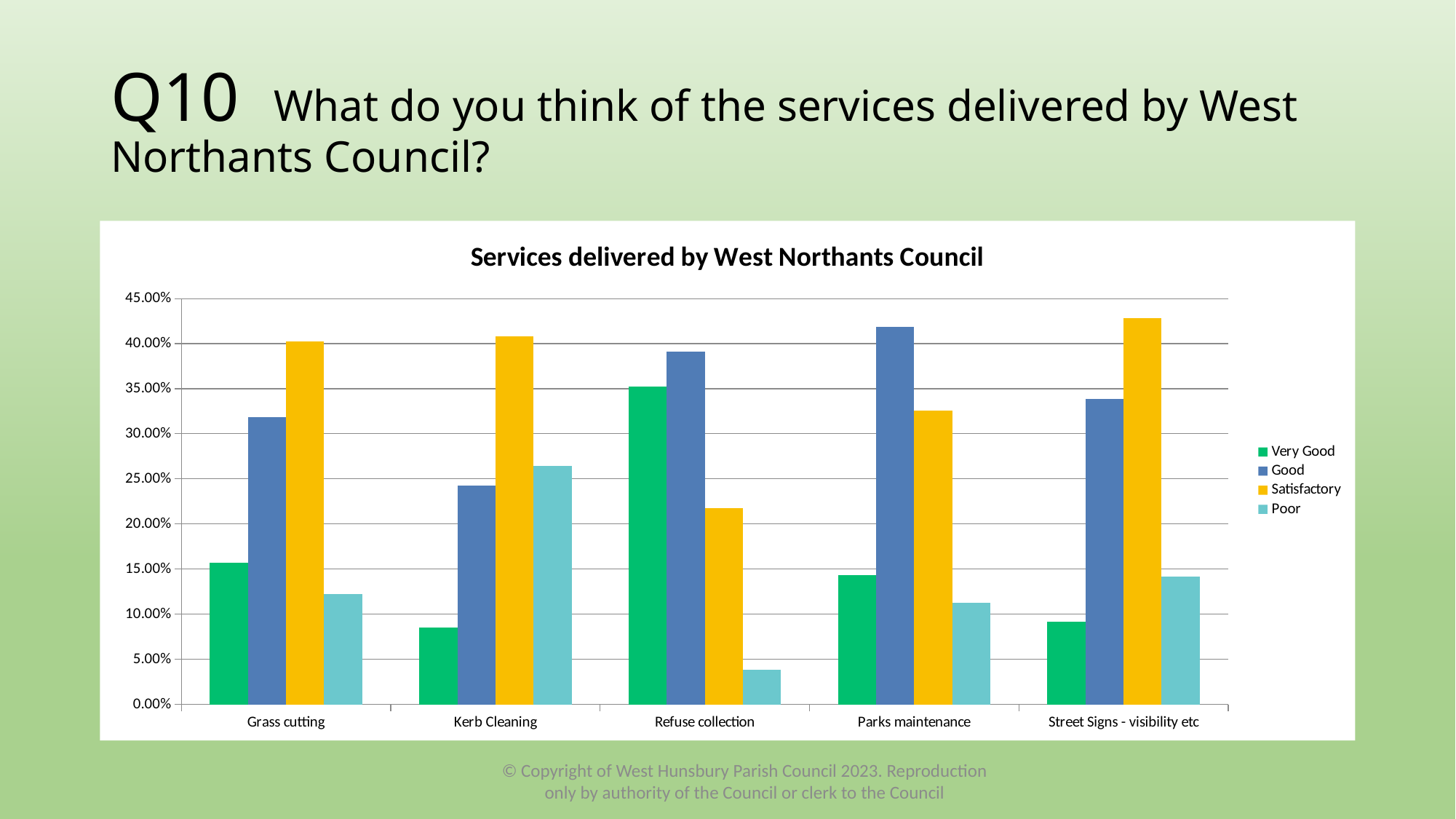
Which service has the lowest Poor rating? Refuse collection Which service has the highest Very Good rating? Refuse collection Is the Very Good value for Kerb Cleaning greater or less than 10.00%? less Is the Satisfactory value for Grass cutting greater or less than 35.00%? greater What kind of chart is shown on the slide? Bar chart How many service categories are shown on the x axis of the chart? 5 Which is larger: the Good value for Parks maintenance or the Good value for Grass cutting? Parks maintenance For Refuse collection, which is larger: the Very Good value or the Satisfactory value? Very Good Which rating series has the highest value for Parks maintenance? Good What is the title of the chart? Services delivered by West Northants Council Is the Poor value for Refuse collection greater or less than 5.00%? less How many series does the chart's legend list? 4